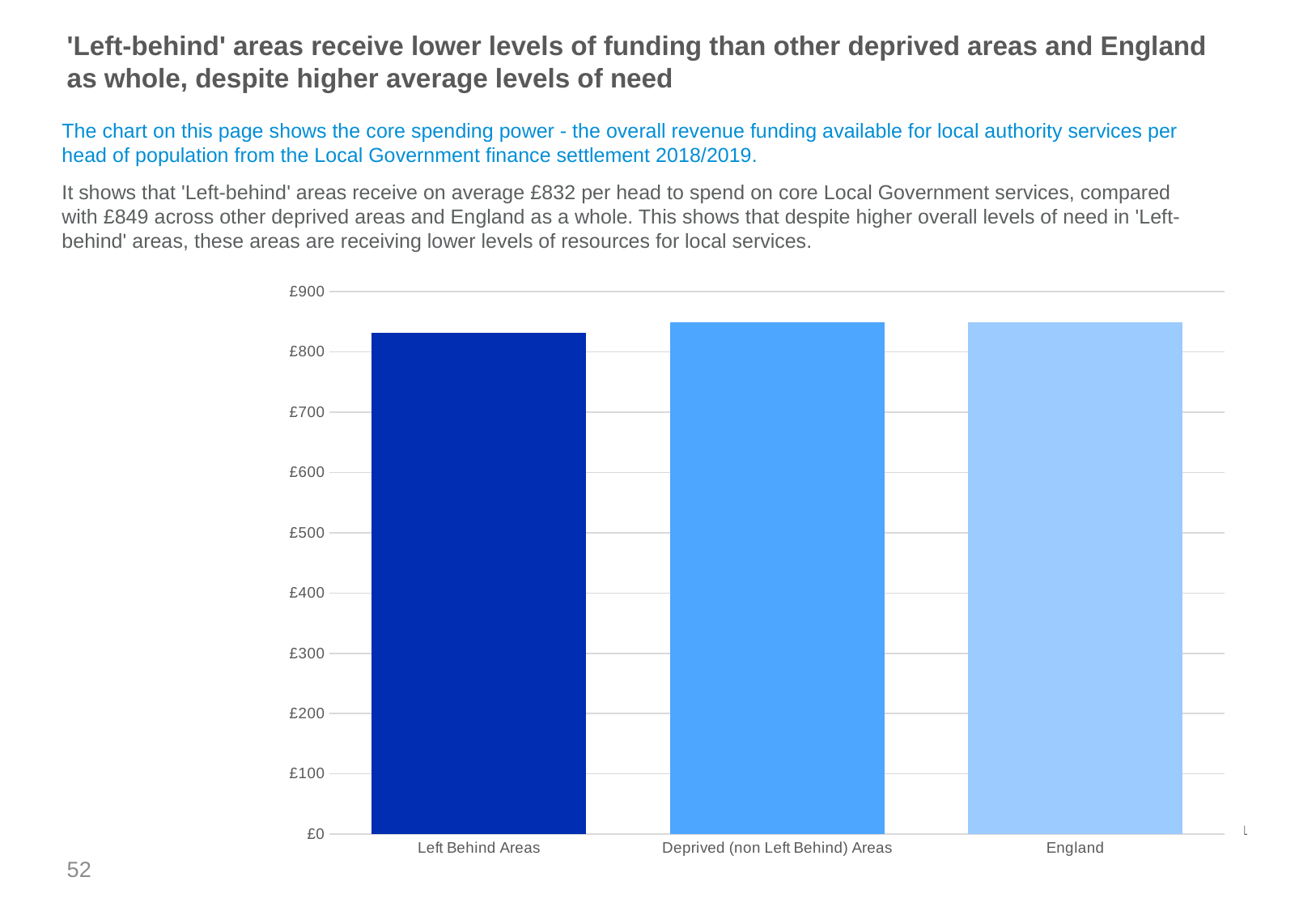
What is the label of the middle category on the x axis? Deprived (non Left Behind) Areas Is the value for Left Behind Areas greater or less than £800? greater Is the value for Left Behind Areas greater or less than £900? less Which is larger, the value for Deprived (non Left Behind) Areas or the value for Left Behind Areas? Deprived (non Left Behind) Areas Which category has the lowest bar in the chart? Left Behind Areas Is the value for England greater or less than £800? greater Which is larger, the value for Left Behind Areas or the value for England? England How many categories are shown on the x axis of the chart? 3 What is the highest tick label shown on the y axis of the chart? £900 What kind of chart is shown on the slide? bar chart